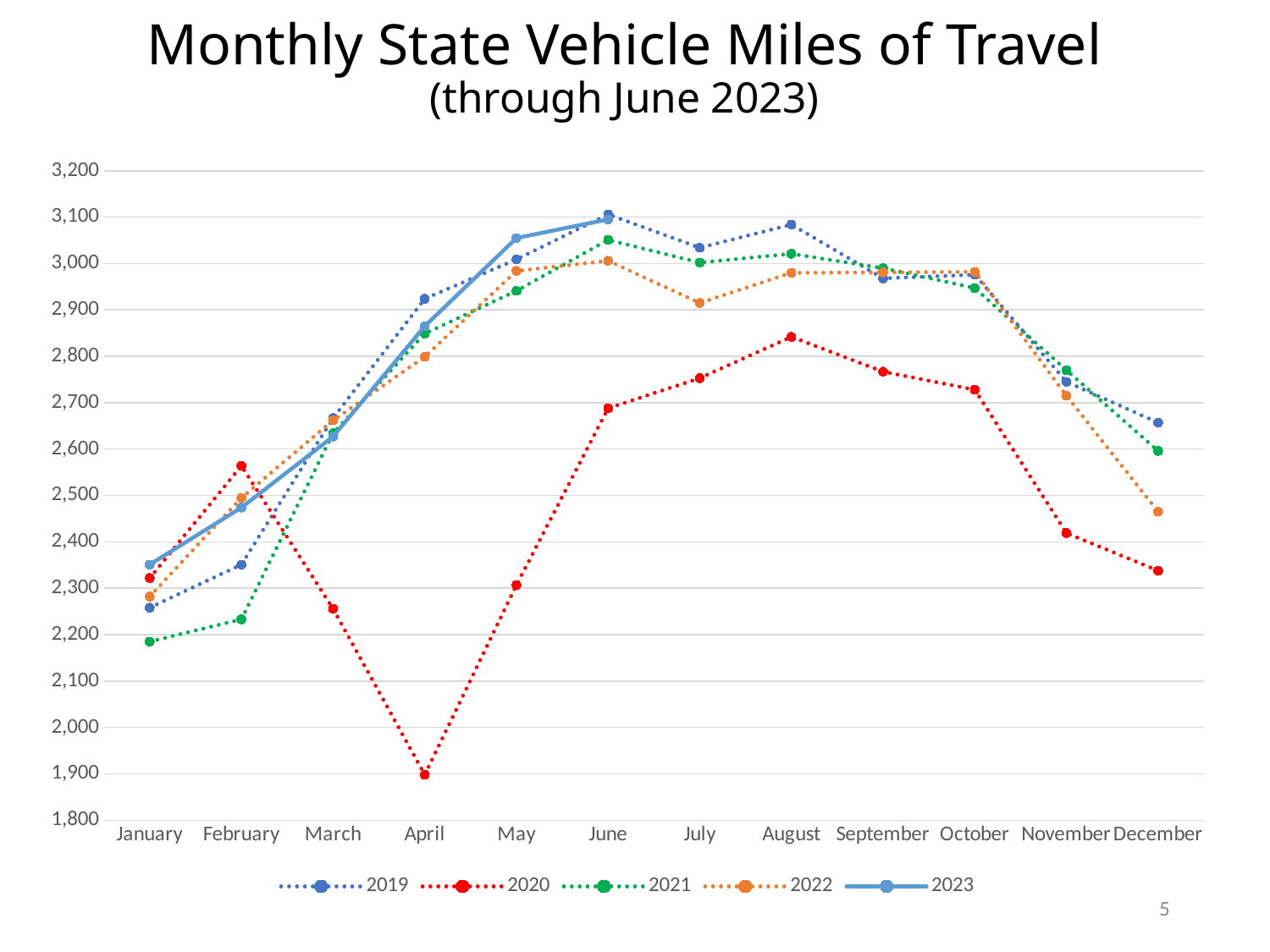
Is the value for 2020 in April greater or less than 2,000? less What kind of chart is shown on the slide? line chart In which month does the 2020 series reach its highest value? August Does the 2023 series rise or fall from January to June? rise How many months are shown along the x axis? 12 Which is larger in April, the value for 2019 or the value for 2020? 2019 Which series has the lowest value in January? 2021 Is the value for 2023 in June greater or less than 3,000? greater Which is larger in February, the value for 2019 or the value for 2020? 2020 In which month does the 2020 series reach its lowest value? April How many series does the legend list? 5 Is the value for 2020 in December greater or less than 2,400? less